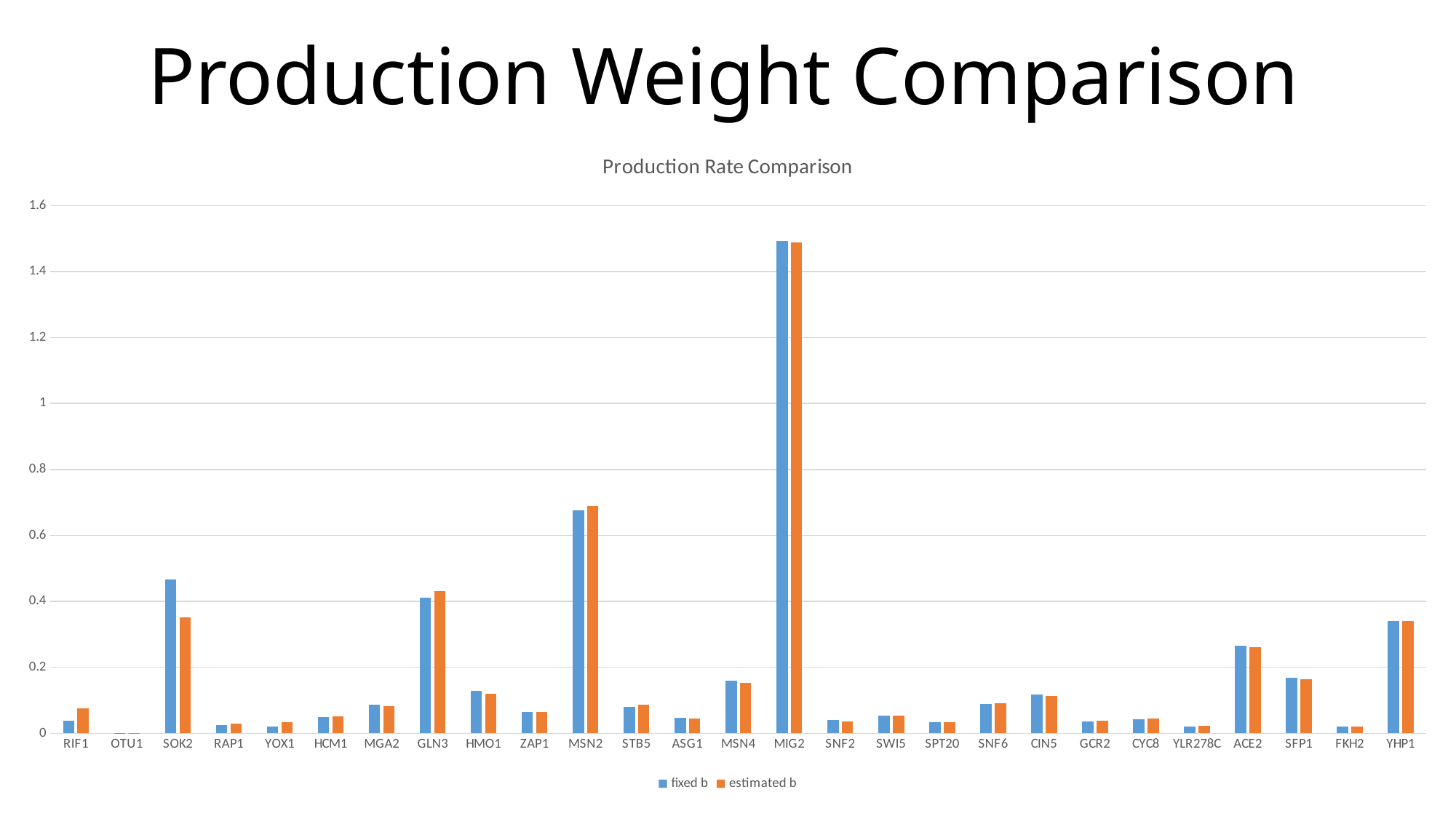
Is the fixed b value for MSN2 greater or less than 0.6? greater How many series does the legend list? 2 Is the fixed b value for MIG2 greater or less than 1.4? greater How many categories are shown along the x axis? 27 Which category has the lowest fixed b value? OTU1 For SOK2, which is larger: fixed b or estimated b? fixed b Which category has the highest fixed b value? MIG2 What is the title shown inside the chart area? Production Rate Comparison Is the estimated b value for SOK2 greater or less than 0.4? less Which category has the highest estimated b value? MIG2 What kind of chart is shown on the slide? bar chart For RIF1, which is larger: fixed b or estimated b? estimated b